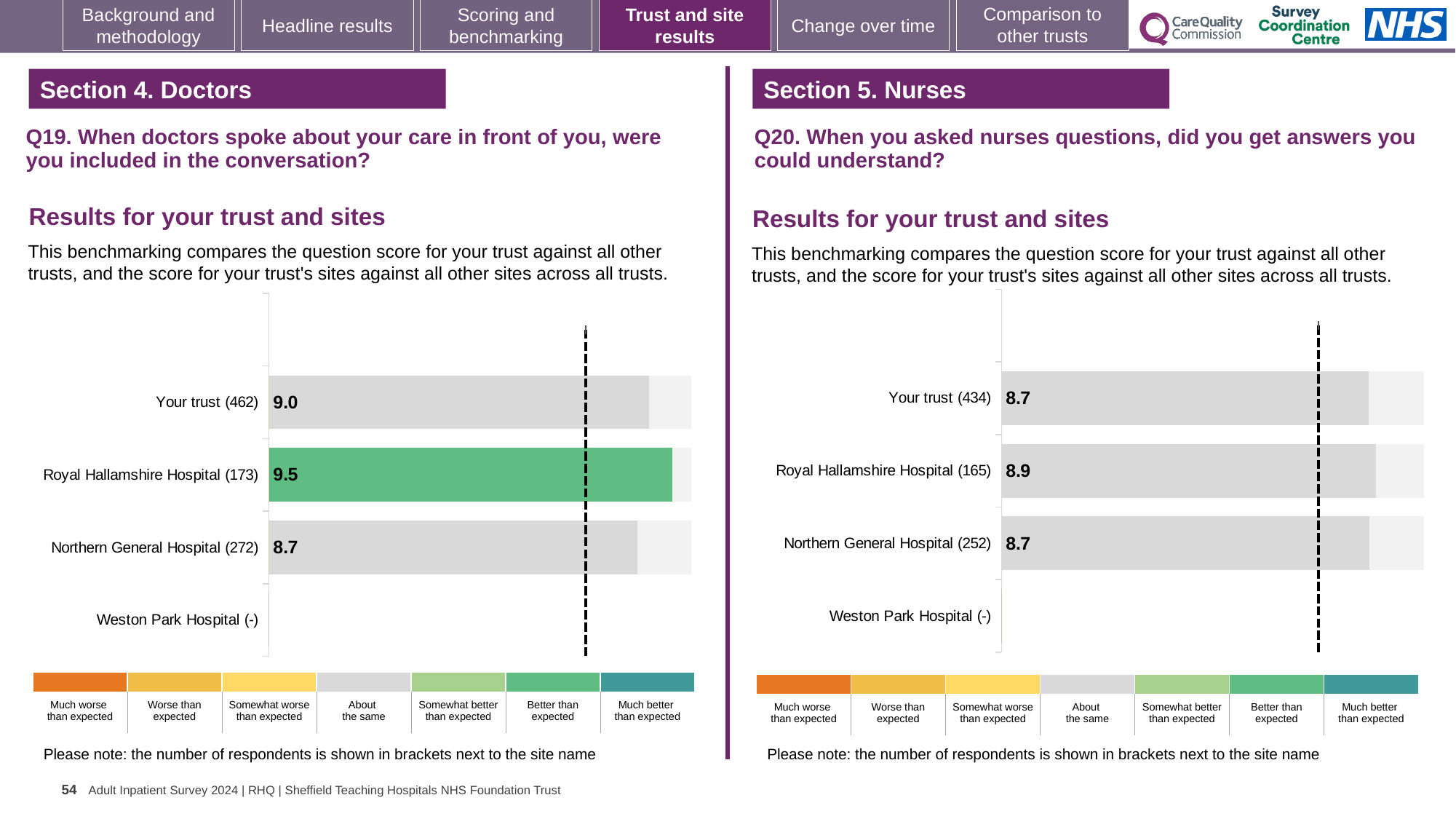
In the Q19 chart (Section 4. Doctors), which site has the highest score? Royal Hallamshire Hospital In the Q20 chart (Section 5. Nurses), how many respondents are shown in brackets for Northern General Hospital? 252 In the Q19 chart (Section 4. Doctors), what is the difference between the scores for Royal Hallamshire Hospital and Northern General Hospital? 0.8 In the Q19 chart (Section 4. Doctors), what is the score for Your trust? 9.0 In the Q19 chart (Section 4. Doctors), what is the score for Royal Hallamshire Hospital? 9.5 In the Q19 chart (Section 4. Doctors), how many respondents are shown in brackets for Your trust? 462 In the Q20 chart (Section 5. Nurses), what is the score for Royal Hallamshire Hospital? 8.9 What kind of chart is used in the Q19 chart (Section 4. Doctors)? Bar chart In the Q20 chart (Section 5. Nurses), what is the difference between the scores for Royal Hallamshire Hospital and Northern General Hospital? 0.2 In the Q20 chart (Section 5. Nurses), which site has the highest score? Royal Hallamshire Hospital In the Q20 chart (Section 5. Nurses), what is the score for Your trust? 8.7 In the Q19 chart (Section 4. Doctors), what is the score for Northern General Hospital? 8.7